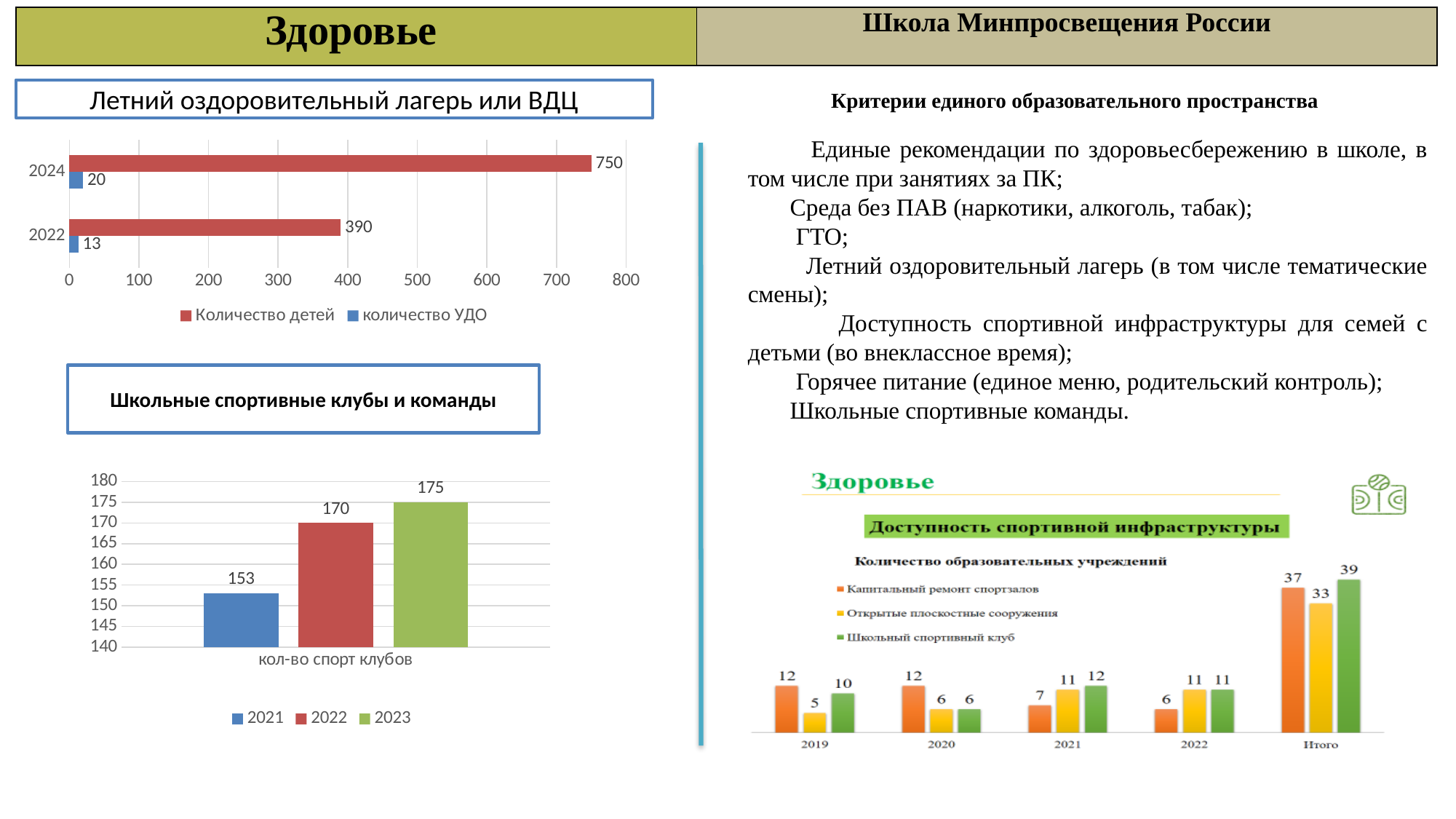
In the chart 'Летний оздоровительный лагерь или ВДЦ', what is the value of 'количество УДО' for 2022? 13 In the chart 'Школьные спортивные клубы и команды', which year has the highest value? 2023 In the chart 'Доступность спортивной инфраструктуры' on the right, what is the value of 'Капитальный ремонт спортзалов' for 2021? 7 In the chart 'Летний оздоровительный лагерь или ВДЦ', what is the value of 'Количество детей' for 2024? 750 In the chart 'Летний оздоровительный лагерь или ВДЦ', how many series does the legend list? 2 In the chart 'Летний оздоровительный лагерь или ВДЦ', what is the difference in 'Количество детей' between 2024 and 2022? 360 What kind of chart is 'Летний оздоровительный лагерь или ВДЦ'? bar chart In the chart 'Доступность спортивной инфраструктуры' on the right, what is the 'Итого' value for 'Школьный спортивный клуб'? 39 In the chart 'Школьные спортивные клубы и команды', which year has the lowest value? 2021 In the chart 'Школьные спортивные клубы и команды', what is the value for 2022? 170 In the chart 'Школьные спортивные клубы и команды', do the values rise or fall from 2021 to 2023? rise In the chart 'Школьные спортивные клубы и команды', what is the difference between the values for 2023 and 2021? 22